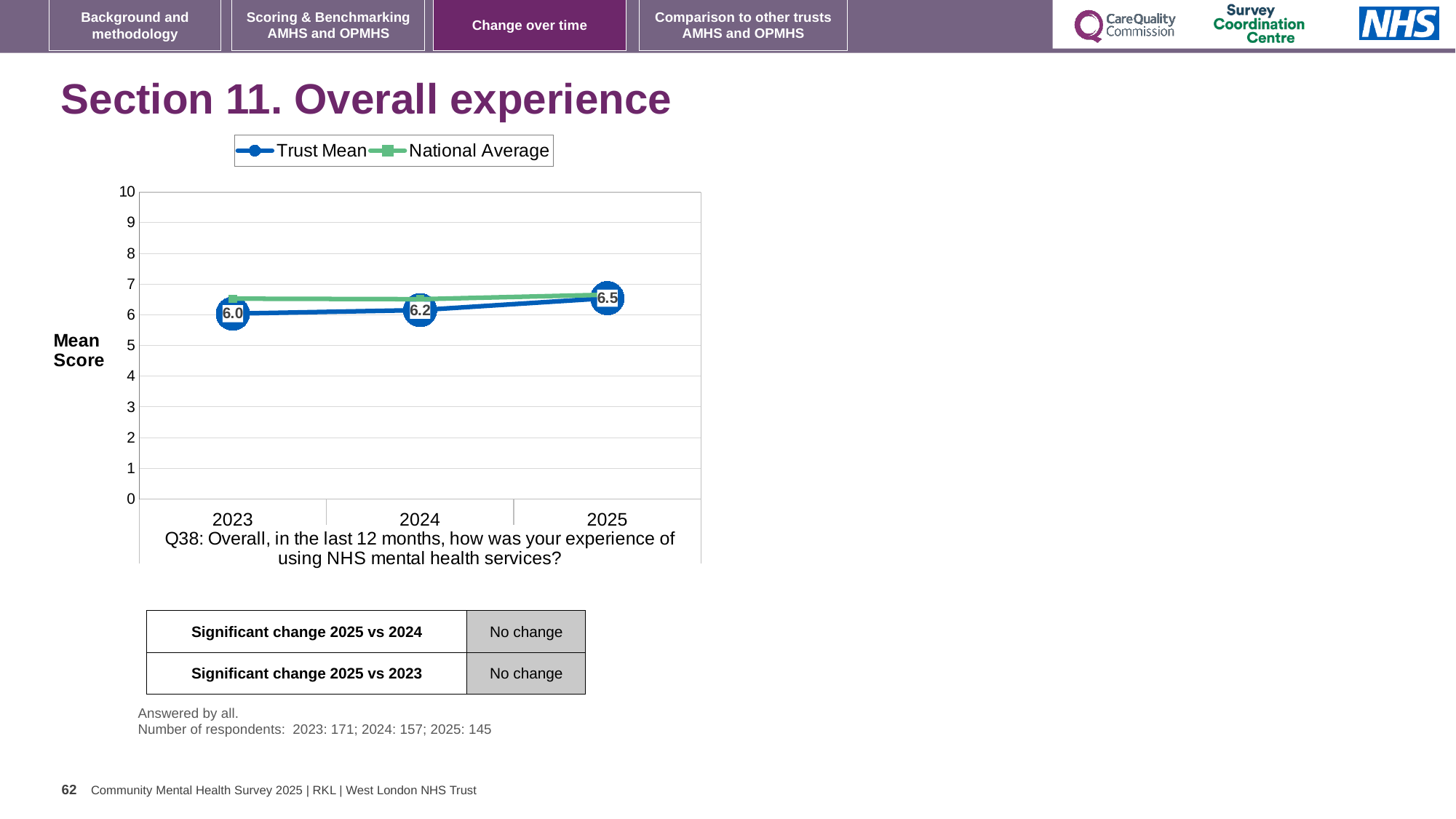
What is the Trust Mean score for 2023? 6.0 In which year is the Trust Mean highest? 2025 What is the Trust Mean score for 2024? 6.2 Is the National Average value for 2023 greater or less than 6? greater How many years are plotted on the x axis? 3 Does the Trust Mean rise or fall from 2023 to 2025? Rise What is the Trust Mean score for 2025? 6.5 In which year is the Trust Mean lowest? 2023 Which is larger in 2023: the Trust Mean or the National Average? National Average How many series does the legend list? 2 What kind of chart is shown on the slide? Line chart What is the difference between the Trust Mean in 2025 and in 2023? 0.5